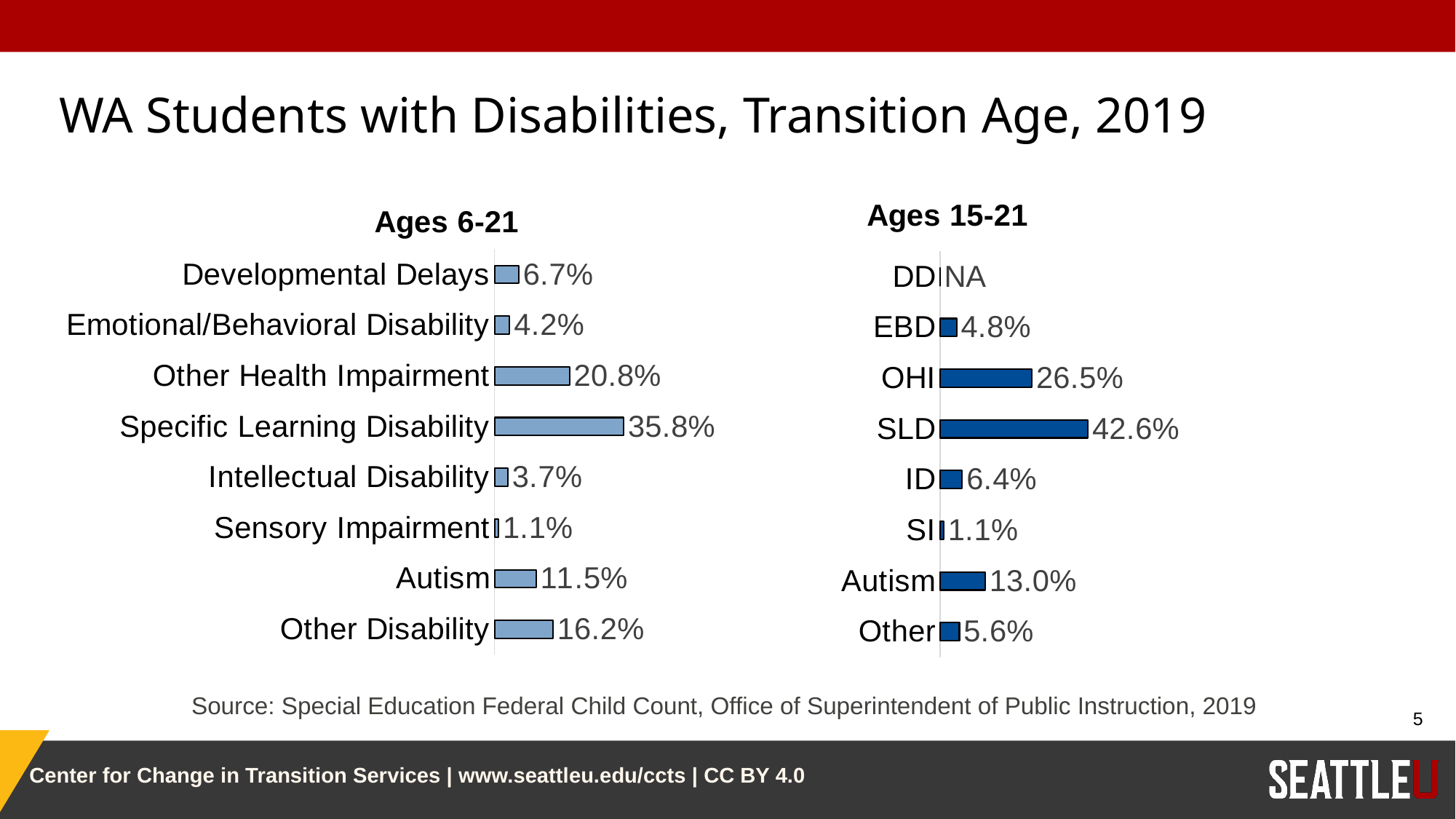
In the Ages 6-21 chart, what is the value for Autism? 11.5% In the Ages 6-21 chart, what is the value for Specific Learning Disability? 35.8% In the Ages 15-21 chart, which category has the lowest value among those with a numeric value? SI In the Ages 6-21 chart, which category has the lowest value? Sensory Impairment In the Ages 15-21 chart, what is the value for Other? 5.6% In the Ages 6-21 chart, what is the difference between Other Health Impairment and Other Disability? 4.6% In the Ages 15-21 chart, what is the value for OHI? 26.5% How many categories are shown in the Ages 15-21 chart? 8 What type of chart is the Ages 6-21 chart? Bar chart In the Ages 15-21 chart, what is the difference between SLD and OHI? 16.1% In the Ages 6-21 chart, which category has the highest value? Specific Learning Disability In the Ages 6-21 chart, which is larger, Developmental Delays or Emotional/Behavioral Disability? Developmental Delays